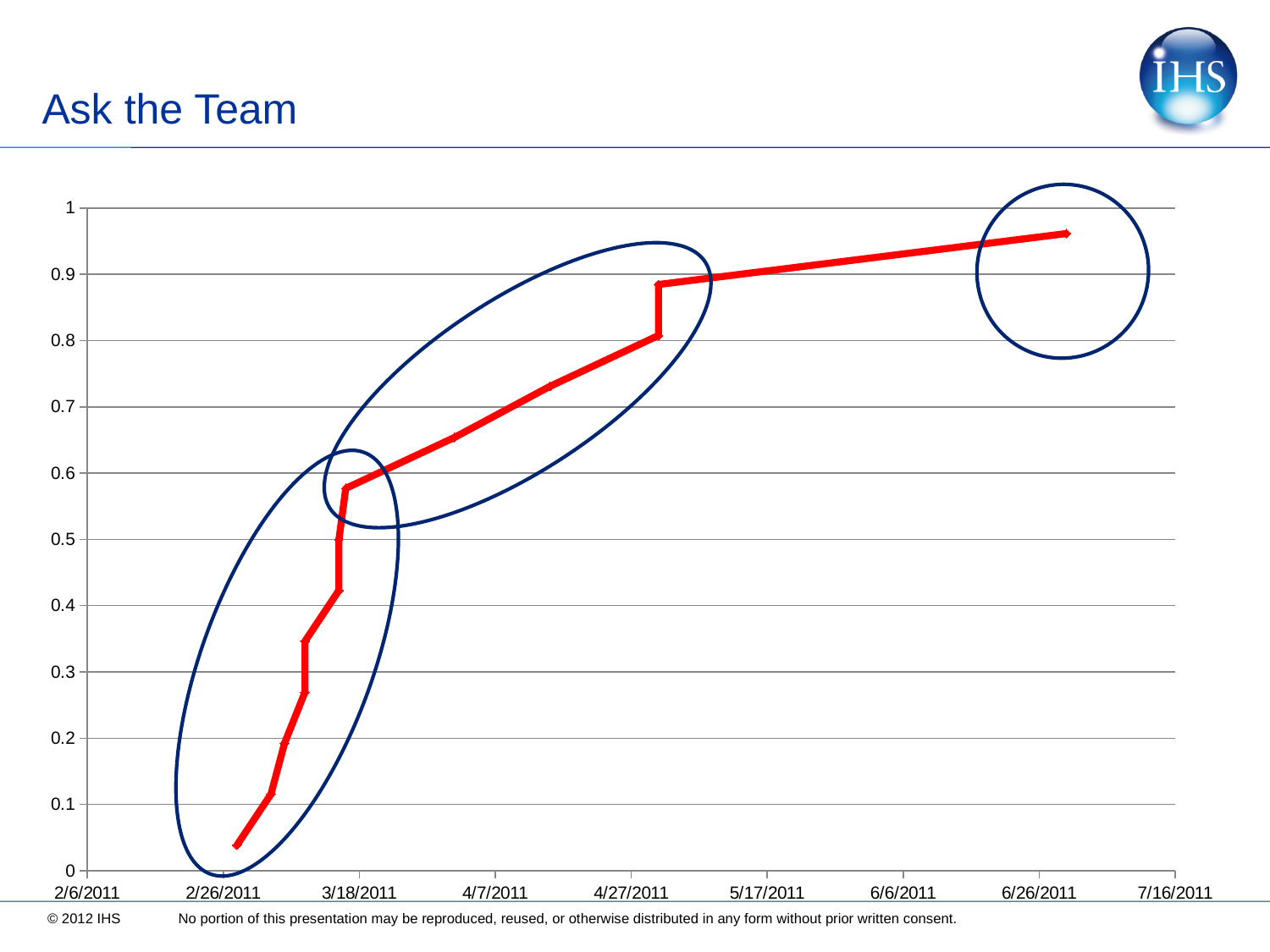
Is the value at the left-hand start of the red line (just after 2/26/2011) greater or less than 0.1? less What is the highest value shown on the y axis? 1 Is the value of the red line at about 3/18/2011 greater or less than 0.5? greater How many blue ellipses are drawn over the chart to highlight parts of the line? 3 Which end of the red line has the higher value, the left end near 2/26/2011 or the right end near 6/26/2011? the right end near 6/26/2011 Is the value of the red line at about 4/27/2011 greater or less than 0.7? greater What kind of chart is shown on the slide? line chart How many date labels are shown along the x axis? 9 Do the values on the red line rise or fall as the dates move from left to right along the x axis? rise